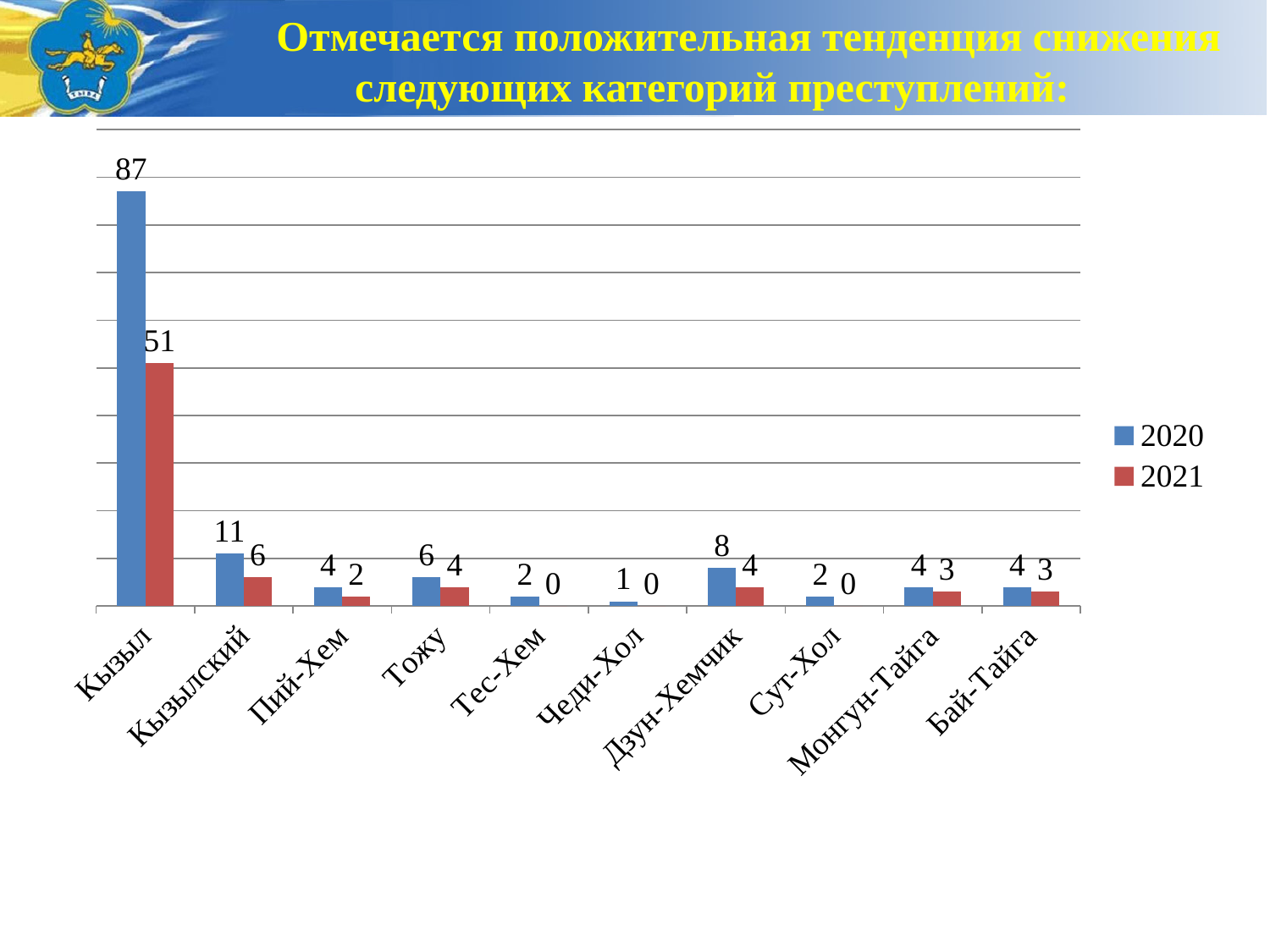
What is the difference between the 2020 and 2021 values for Кызыл? 36 How many categories are shown on the x axis? 10 How many series does the legend list? 2 What is the value for Кызыл in 2020? 87 What is the value for Кызыл in 2021? 51 What kind of chart is shown on the slide? bar chart Which is larger for Тожу: the 2020 value or the 2021 value? 2020 What is the value for Дзун-Хемчик in 2020? 8 What is the value for Кызылский in 2021? 6 Which category has the highest value in 2020? Кызыл Which category has the lowest value in 2020? Чеди-Хол What is the difference between the 2020 and 2021 values for Кызылский? 5